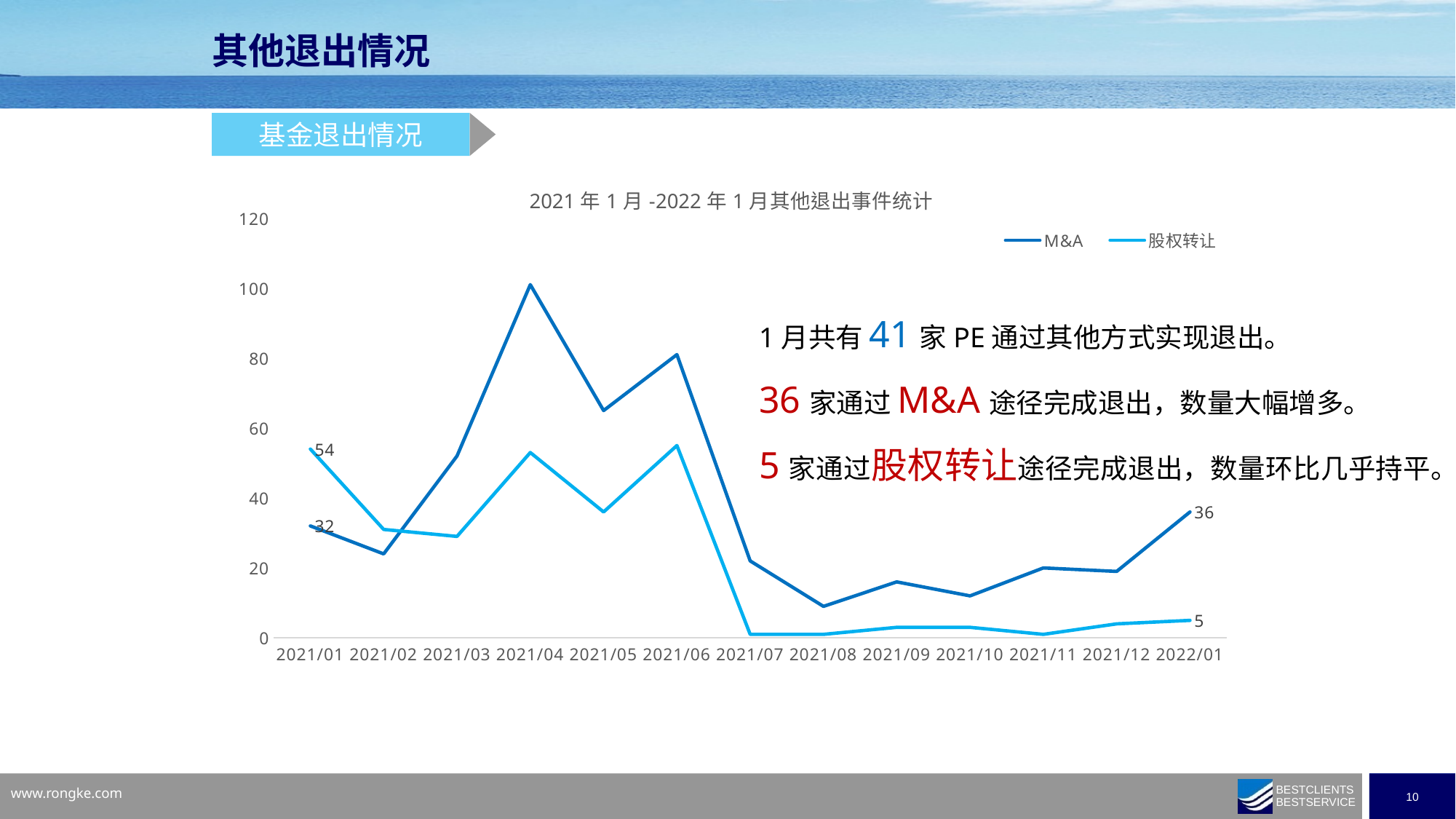
Which series has the larger value in 2021/01, M&A or 股权转让? 股权转让 How many time points are plotted along the x axis? 13 Is the M&A value for 2021/04 greater or less than 80? greater What type of chart is shown on the slide? line chart What is the difference between the M&A value and the 股权转让 value in 2022/01? 31 In which month does the M&A series reach its highest value? 2021/04 How many series does the chart legend list? 2 What is the 股权转让 value for 2021/01? 54 What is the M&A value for 2022/01? 36 What is the title of the chart? 2021年1月-2022年1月其他退出事件统计 What is the M&A value for 2021/01? 32 What is the 股权转让 value for 2022/01? 5